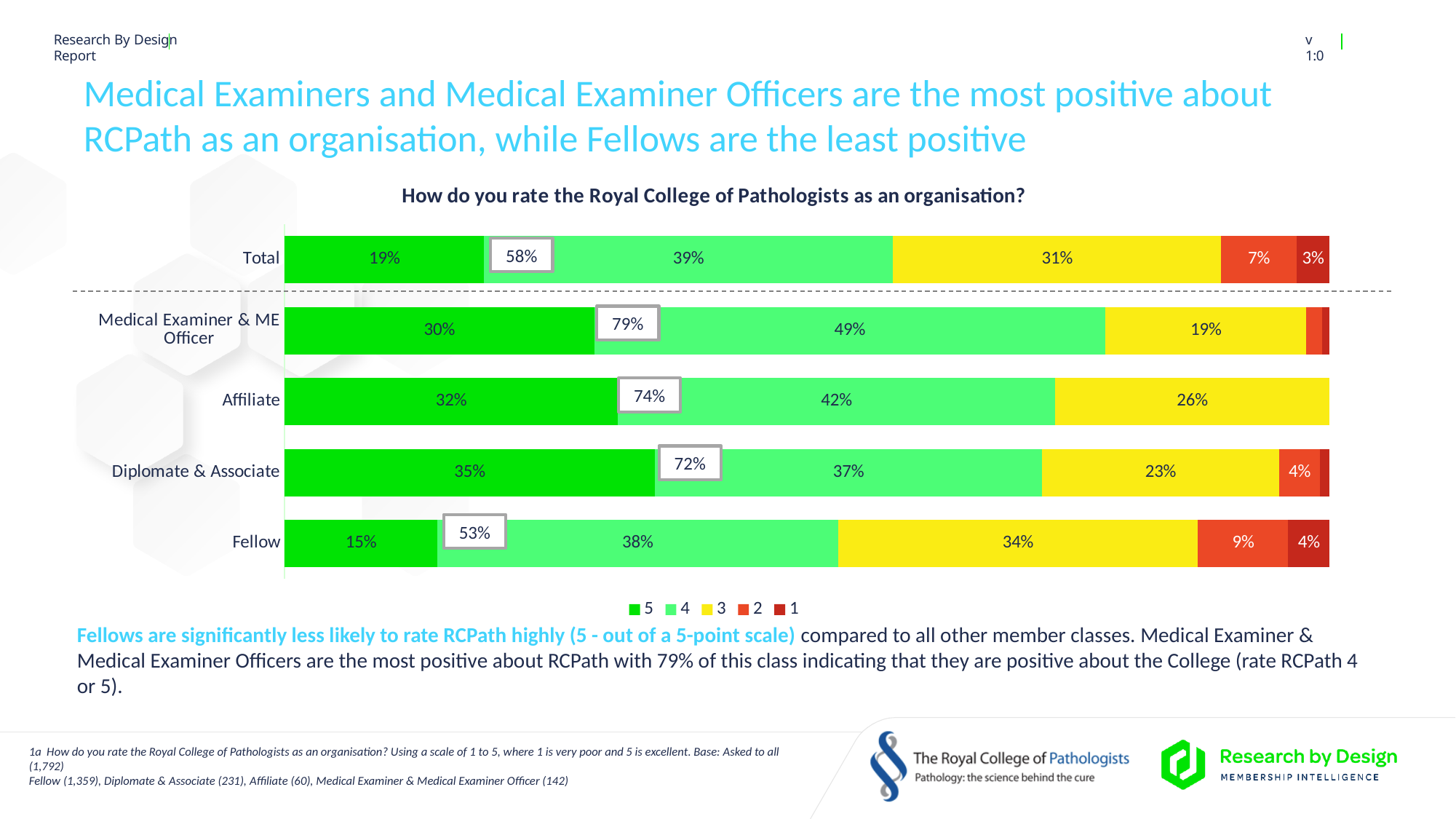
What percentage of Affiliates rated RCPath as 3? 26% Which is larger: the percentage of Fellows rating RCPath as 3 or the percentage of the Total rating it as 3? Fellow What is the difference between the percentage of Fellows and the percentage of Medical Examiner & ME Officer respondents rating RCPath as 5? 15% How many series does the legend list? 5 Which member class has the highest percentage rating RCPath as 5? Diplomate & Associate What type of chart is shown on the slide? Stacked bar chart How many member classes (including Total) are shown in the chart? 5 What percentage of Fellows rated RCPath as 5? 15% What is the boxed combined (4 or 5) percentage shown for Diplomate & Associate? 72% Which member class has the lowest boxed combined (4 or 5) percentage? Fellow What percentage of Medical Examiner & ME Officer respondents rated RCPath as 4? 49% What is the title of the chart? How do you rate the Royal College of Pathologists as an organisation?